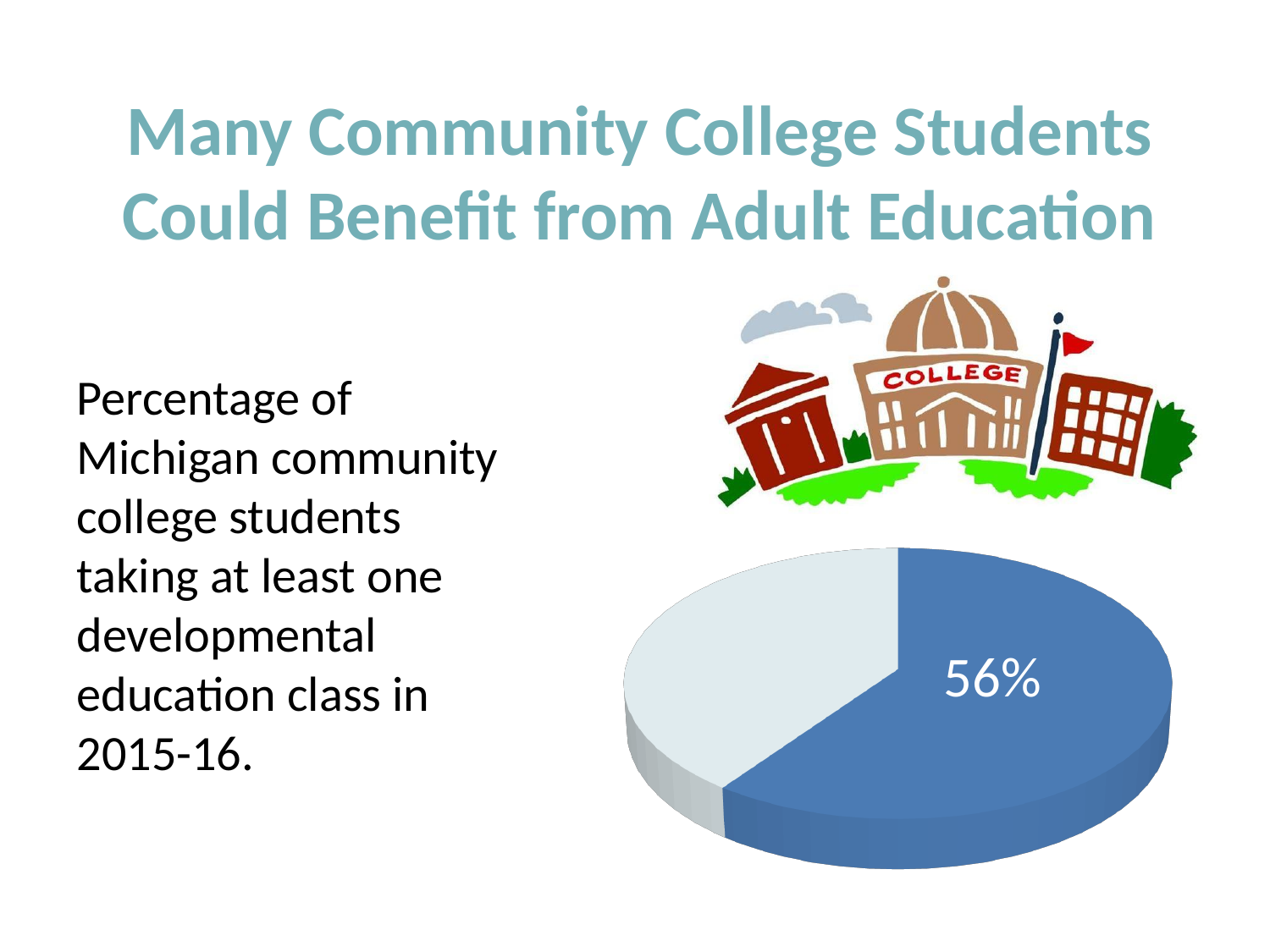
How many slices does the pie chart have? 2 Which slice of the pie chart is the largest? the blue slice (56%) What percentage is printed on the blue slice of the pie chart? 56% What kind of chart is shown on the slide? pie chart Does the pie chart include a legend? No What share of the pie does the blue slice represent? 56% Which slice of the pie chart is the smallest? the light grey slice Which slice of the pie chart has a data label printed on it? the blue slice Which slice of the pie chart is larger, the blue one or the light grey one? blue